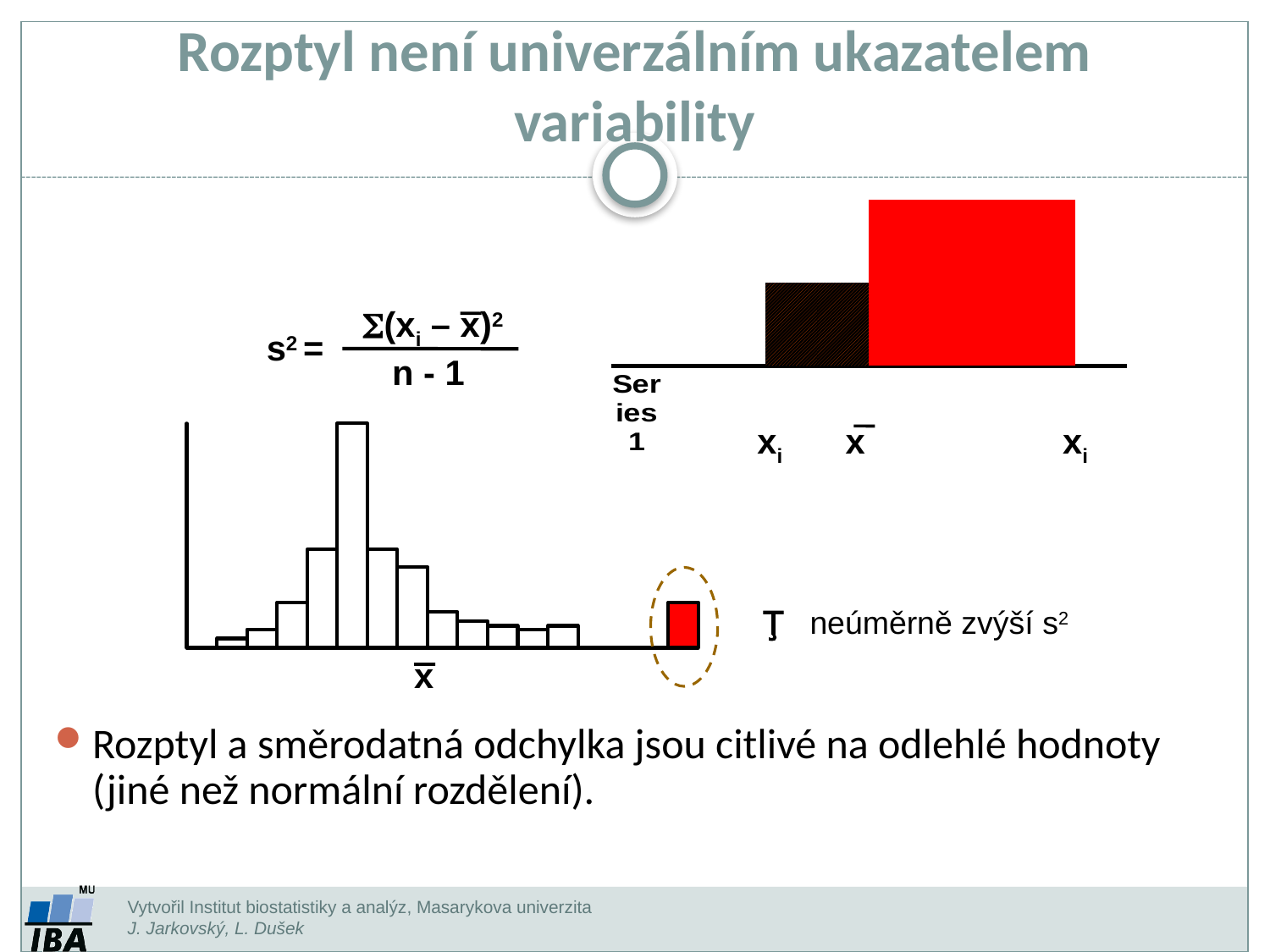
In the chart at the top right, what category label is printed at the left end of the horizontal axis? Series 1 How many bars does the chart at the top right of the slide contain? 2 What kind of chart is shown at the top right of the slide? bar chart In the histogram at the bottom left, is the circled red outlier bar taller or shorter than the tallest bar of the histogram? shorter In the chart at the top right, which bar is taller, the hatched black bar or the red bar? the red bar In the chart at the top right, what colour is the taller bar? red